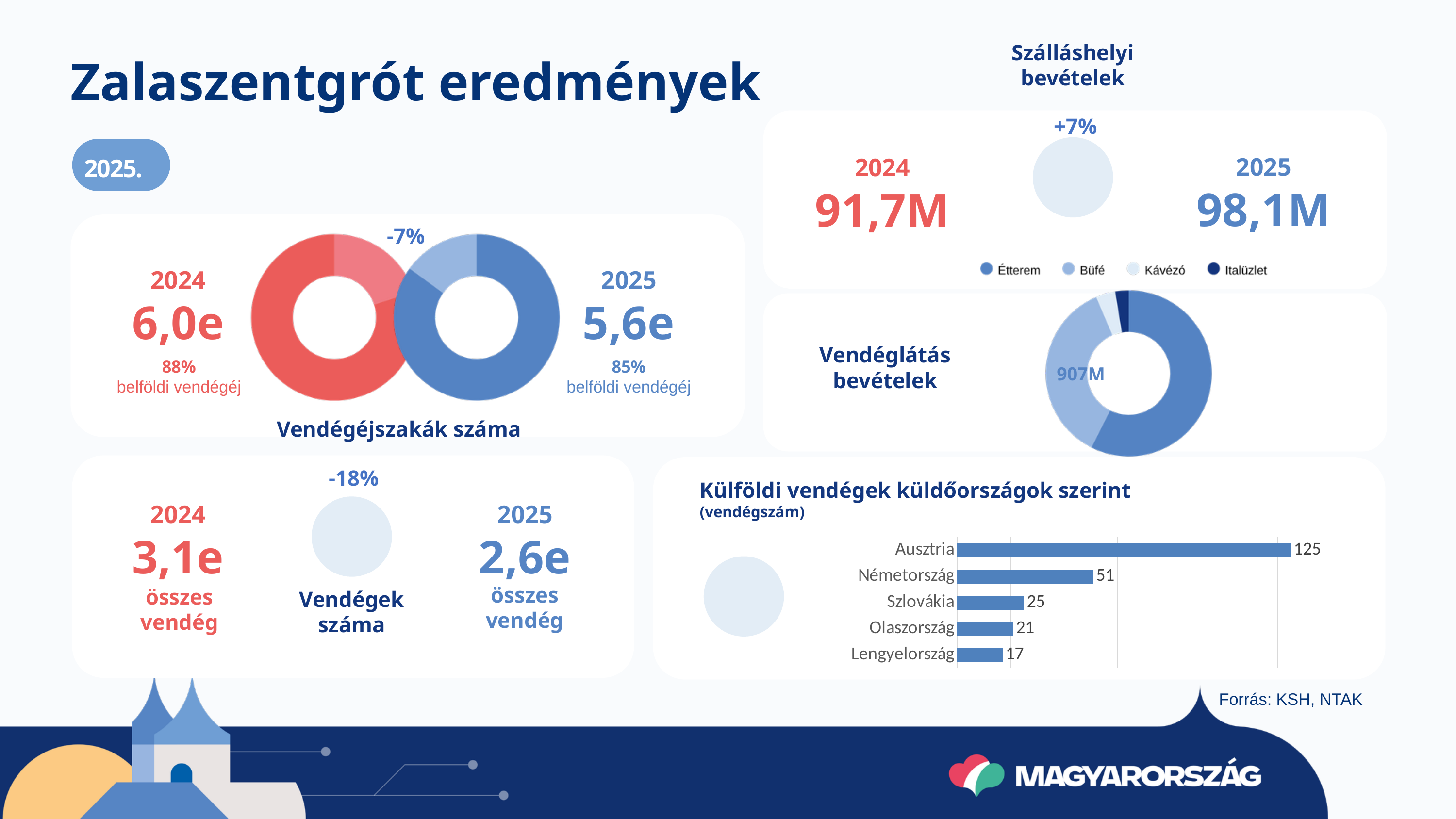
In the 'Vendégéjszakák száma' donut charts, what share of guest nights was domestic (belföldi vendégéj) in 2025? 85% In the 'Külföldi vendégek küldőországok szerint' chart, what is the value for Lengyelország? 17 In the 'Külföldi vendégek küldőországok szerint' chart, which country has the highest value? Ausztria How many countries are shown in the 'Külföldi vendégek küldőországok szerint' chart? 5 In the 'Külföldi vendégek küldőországok szerint' chart, what is the difference between the values for Ausztria and Németország? 74 In the 'Külföldi vendégek küldőországok szerint' chart, which is larger, the value for Szlovákia or Olaszország? Szlovákia In the 'Külföldi vendégek küldőországok szerint' chart, which country has the lowest value? Lengyelország What total value is printed on the 'Vendéglátás bevételek' donut chart? 907M What kind of chart is 'Külföldi vendégek küldőországok szerint'? Bar chart In the 'Külföldi vendégek küldőországok szerint' chart, what is the value for Ausztria? 125 How many series does the legend of the 'Vendéglátás bevételek' donut chart list? 4 In the 'Külföldi vendégek küldőországok szerint' chart, what is the value for Németország? 51